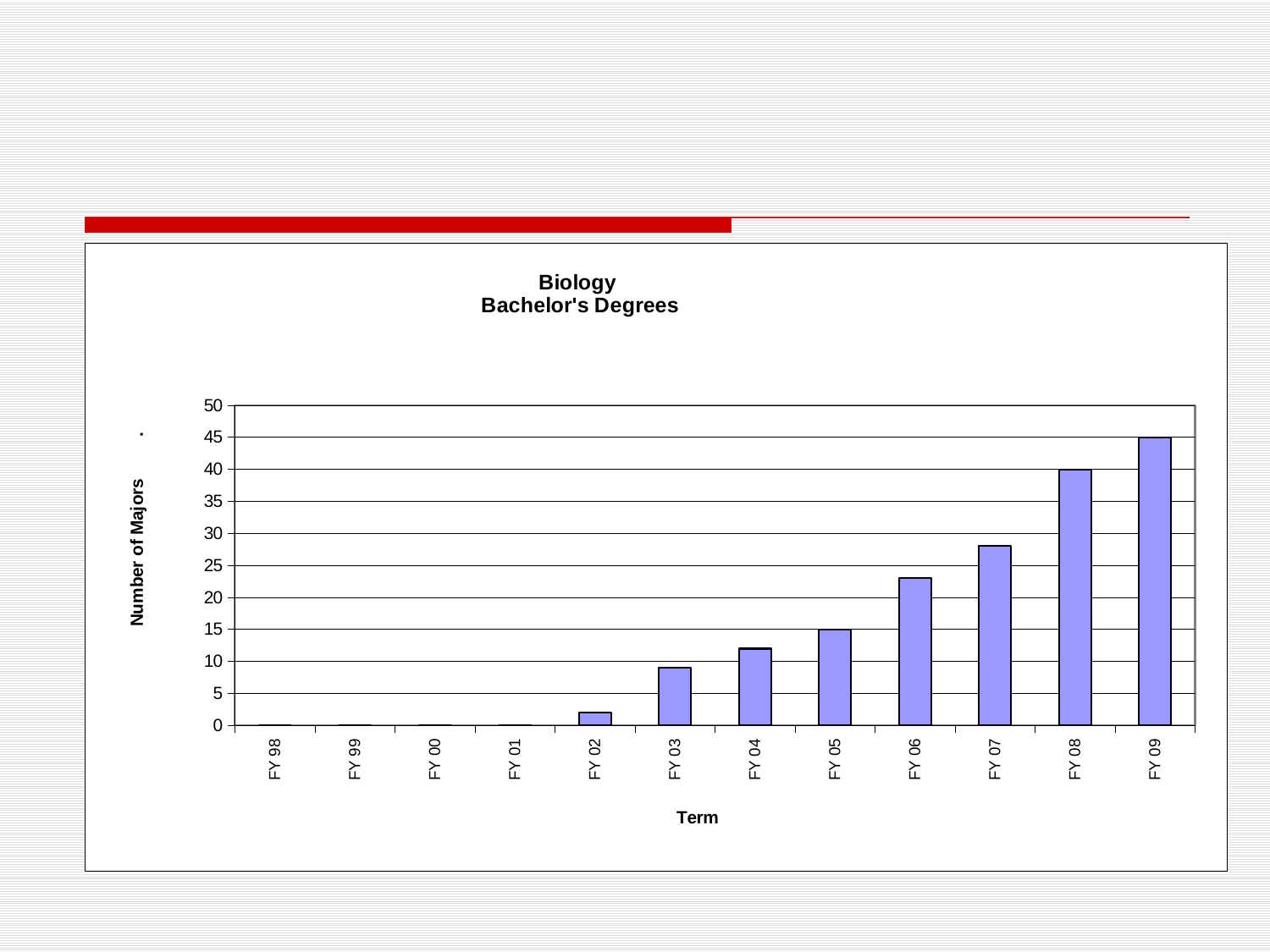
What is the number of majors for FY 09? 45 Is the value for FY 07 greater or less than 25? greater Do the values generally rise or fall from FY 98 to FY 09? rise What is the title of the chart? Biology Bachelor's Degrees Is the value for FY 06 greater or less than 25? less How many fiscal years are shown on the x axis of the chart? 12 Which is larger, the value for FY 04 or the value for FY 03? FY 04 Which is larger, the value for FY 08 or the value for FY 07? FY 08 What is the label on the vertical axis of the chart? Number of Majors Which fiscal year has the highest number of Biology bachelor's degrees? FY 09 What kind of chart is shown on the slide? bar chart